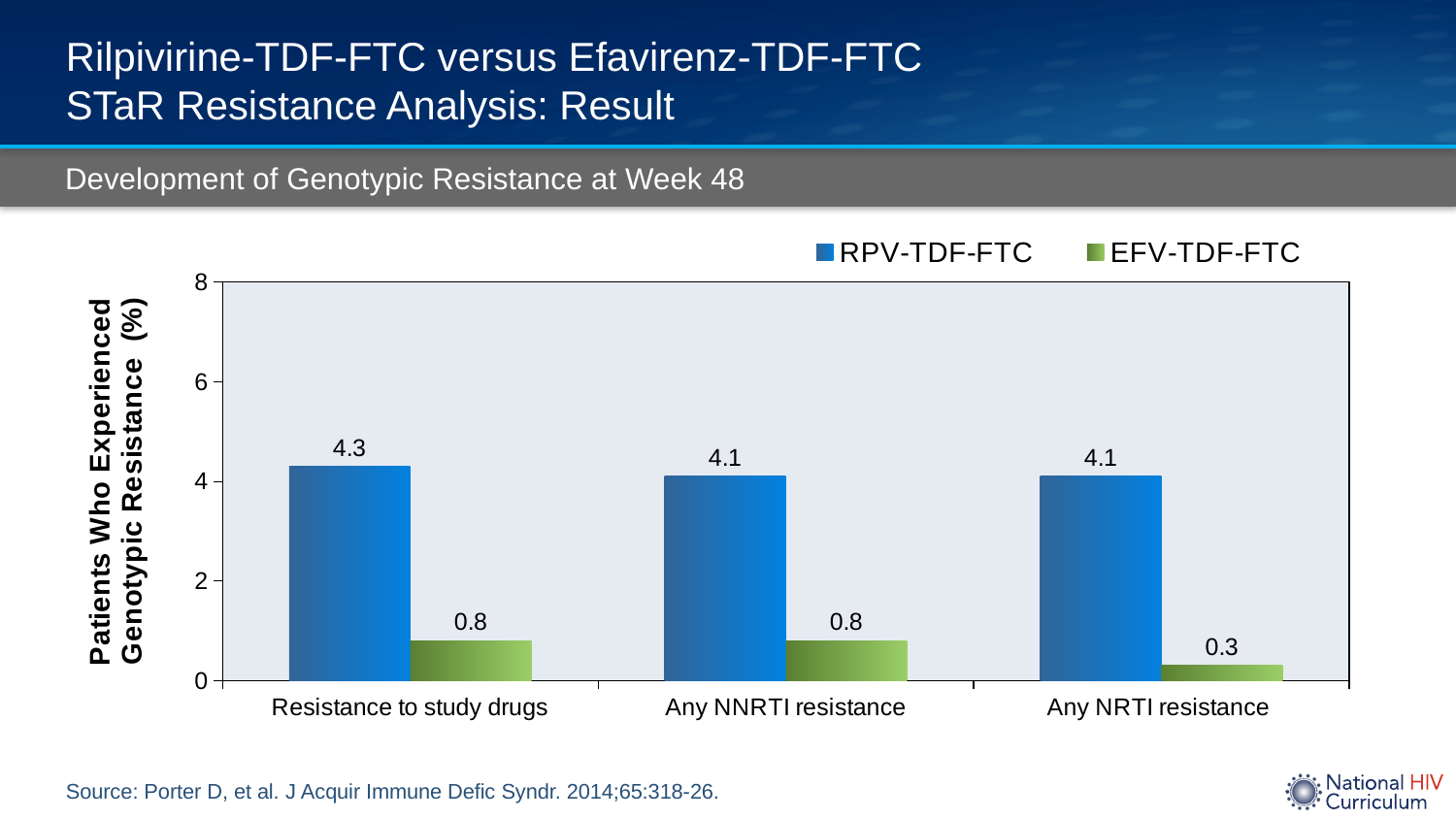
Which category has the lowest value for EFV-TDF-FTC? Any NRTI resistance What is the difference between the RPV-TDF-FTC and EFV-TDF-FTC values in the 'Resistance to study drugs' category? 3.5 Which category has the highest value for RPV-TDF-FTC? Resistance to study drugs Is the value for RPV-TDF-FTC in 'Any NRTI resistance' greater or less than 6? less How many series does the legend list? 2 What is the value for RPV-TDF-FTC in the 'Resistance to study drugs' category? 4.3 What kind of chart is shown on the slide? bar chart What is the value for EFV-TDF-FTC in the 'Any NRTI resistance' category? 0.3 What is the difference between the RPV-TDF-FTC and EFV-TDF-FTC values in the 'Any NRTI resistance' category? 3.8 How many categories are shown on the x axis? 3 In the 'Any NNRTI resistance' category, which series has the larger value, RPV-TDF-FTC or EFV-TDF-FTC? RPV-TDF-FTC What is the value for EFV-TDF-FTC in the 'Any NNRTI resistance' category? 0.8